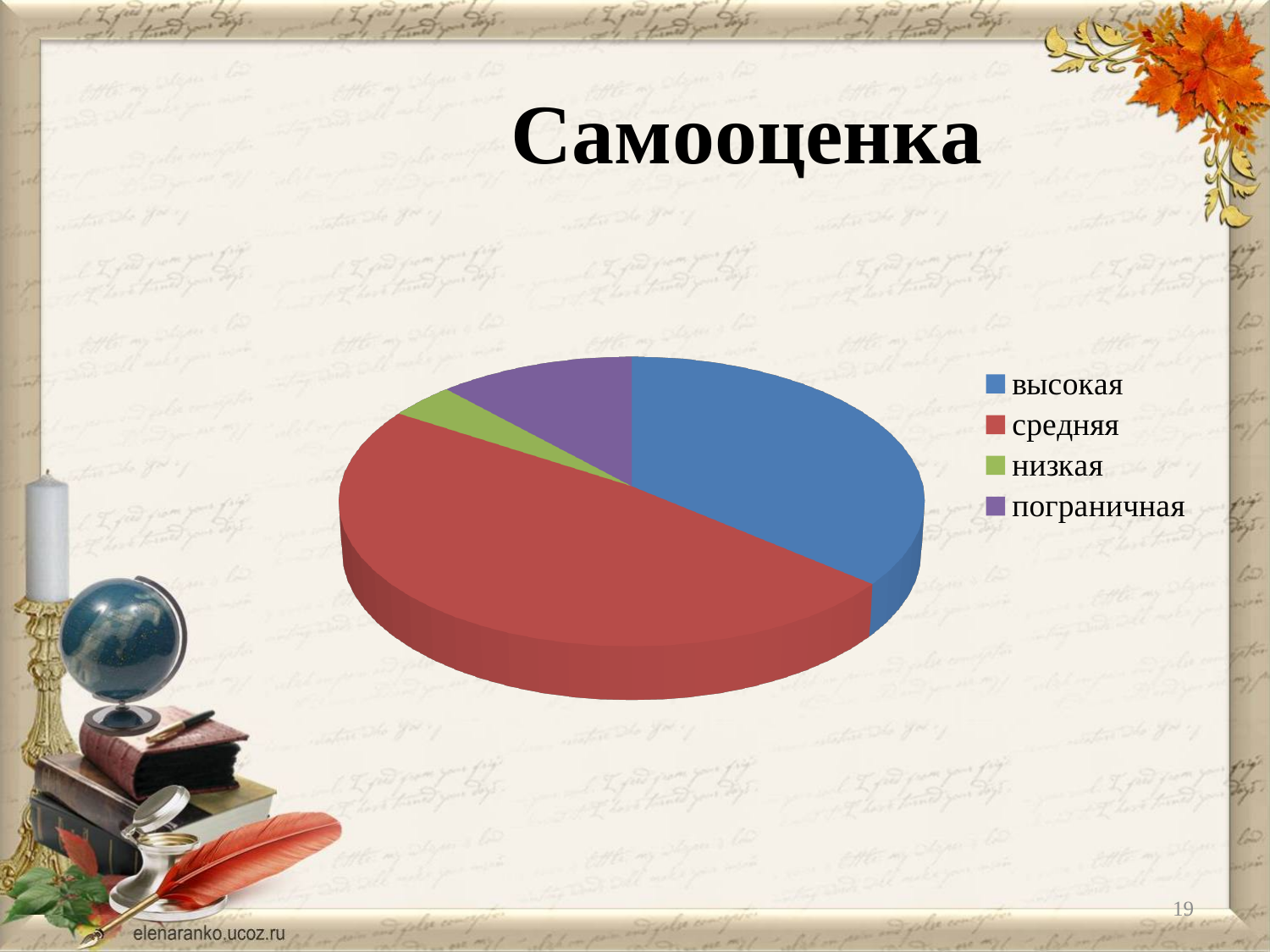
Which category is shown in blue in the legend? высокая What is the title of the chart? Самооценка How many categories does the pie chart have? 4 Which slice is larger, пограничная or низкая? пограничная Which category has the largest slice of the pie? средняя Which category has the smallest slice of the pie? низкая What kind of chart is shown on the slide? pie chart Which slice is larger, высокая or пограничная? высокая Which slice is larger, средняя or высокая? средняя How many entries does the legend list? 4